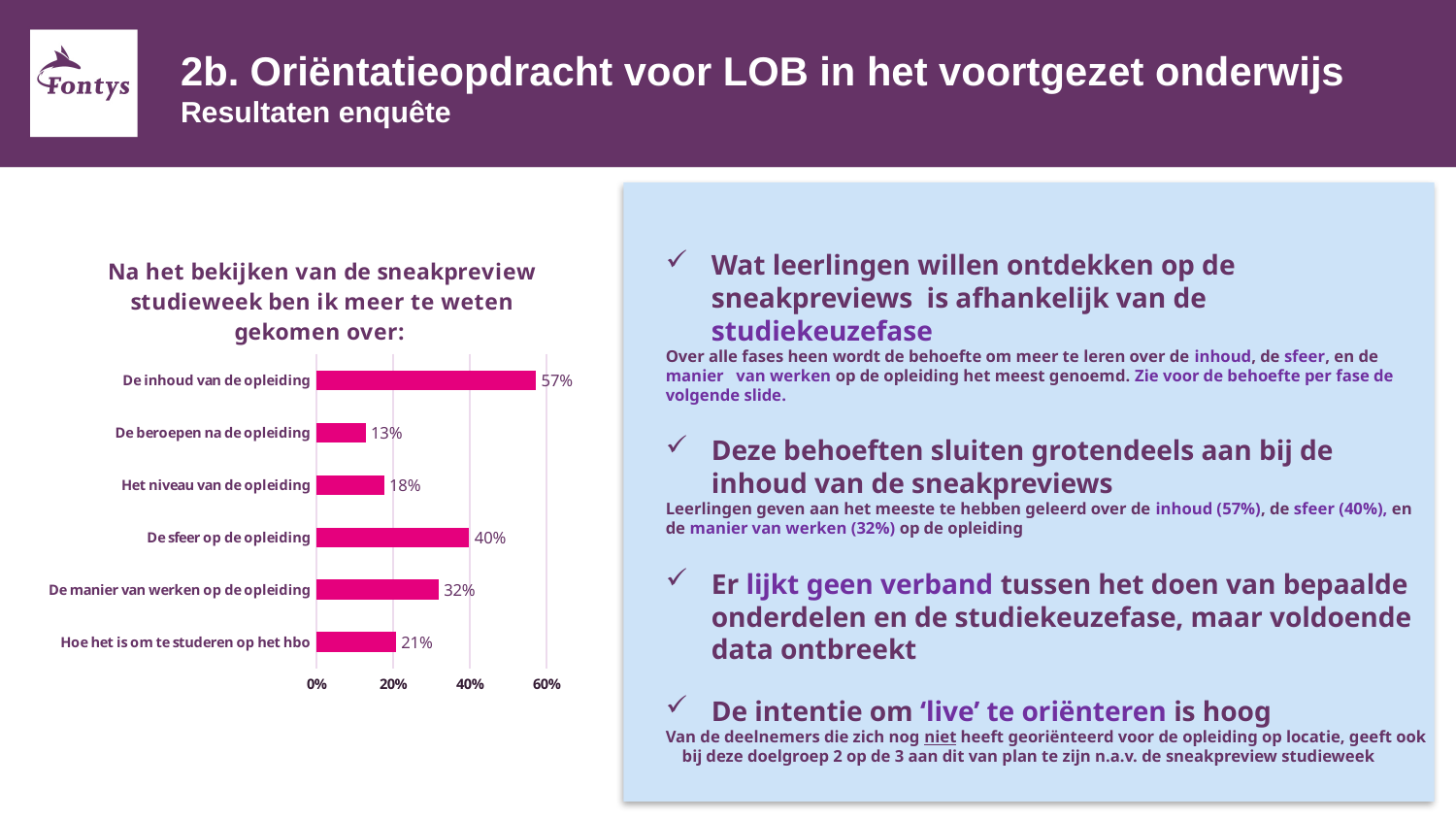
How many categories are shown in the chart? 6 What is the value for 'De inhoud van de opleiding'? 57% What is the highest tick value shown on the x axis? 60% What is the value for 'Hoe het is om te studeren op het hbo'? 21% Is the value for 'De manier van werken op de opleiding' greater or less than 20%? greater What kind of chart is shown on the slide? bar chart Which category has the highest value? De inhoud van de opleiding What is the title of the chart? Na het bekijken van de sneakpreview studieweek ben ik meer te weten gekomen over: What is the value for 'De sfeer op de opleiding'? 40% Which category has the lowest value? De beroepen na de opleiding Which is larger: 'Het niveau van de opleiding' or 'De manier van werken op de opleiding'? De manier van werken op de opleiding What is the difference between 'De inhoud van de opleiding' and 'De sfeer op de opleiding'? 17%